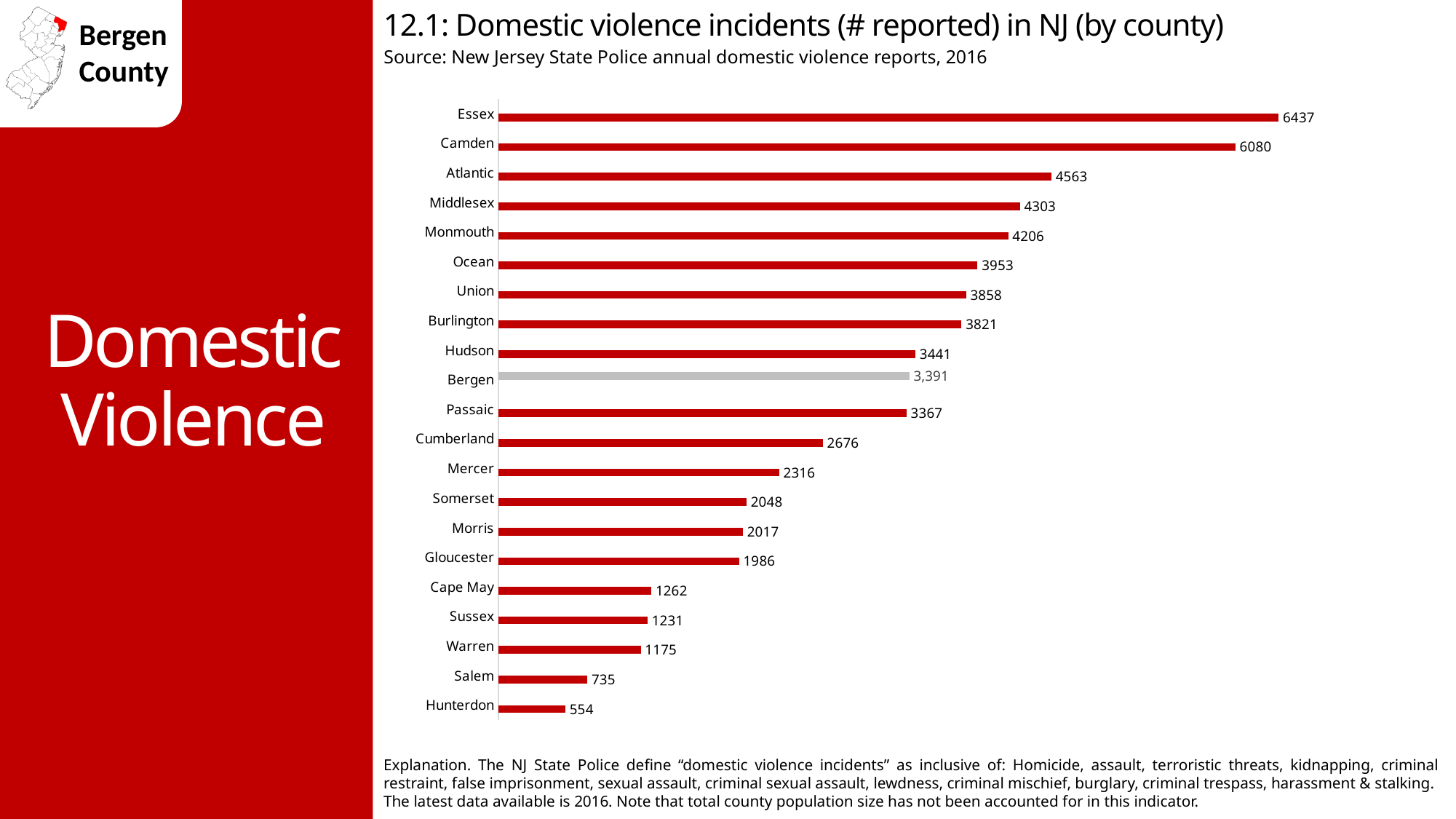
What type of chart is used on this slide? Bar chart What is the number of domestic violence incidents reported for Bergen? 3,391 What is the number of domestic violence incidents reported for Hunterdon? 554 Which county has the lowest number of reported domestic violence incidents? Hunterdon Which county has the highest number of reported domestic violence incidents? Essex How many counties are shown in the chart? 21 Which county has more reported incidents, Atlantic or Middlesex? Atlantic Which county has more reported incidents, Salem or Warren? Warren Which county's bar is shown in grey rather than red? Bergen What is the difference between the number of incidents in Hudson and Bergen? 50 What is the difference between the number of incidents in Essex and Camden? 357 What is the number of domestic violence incidents reported for Essex? 6437